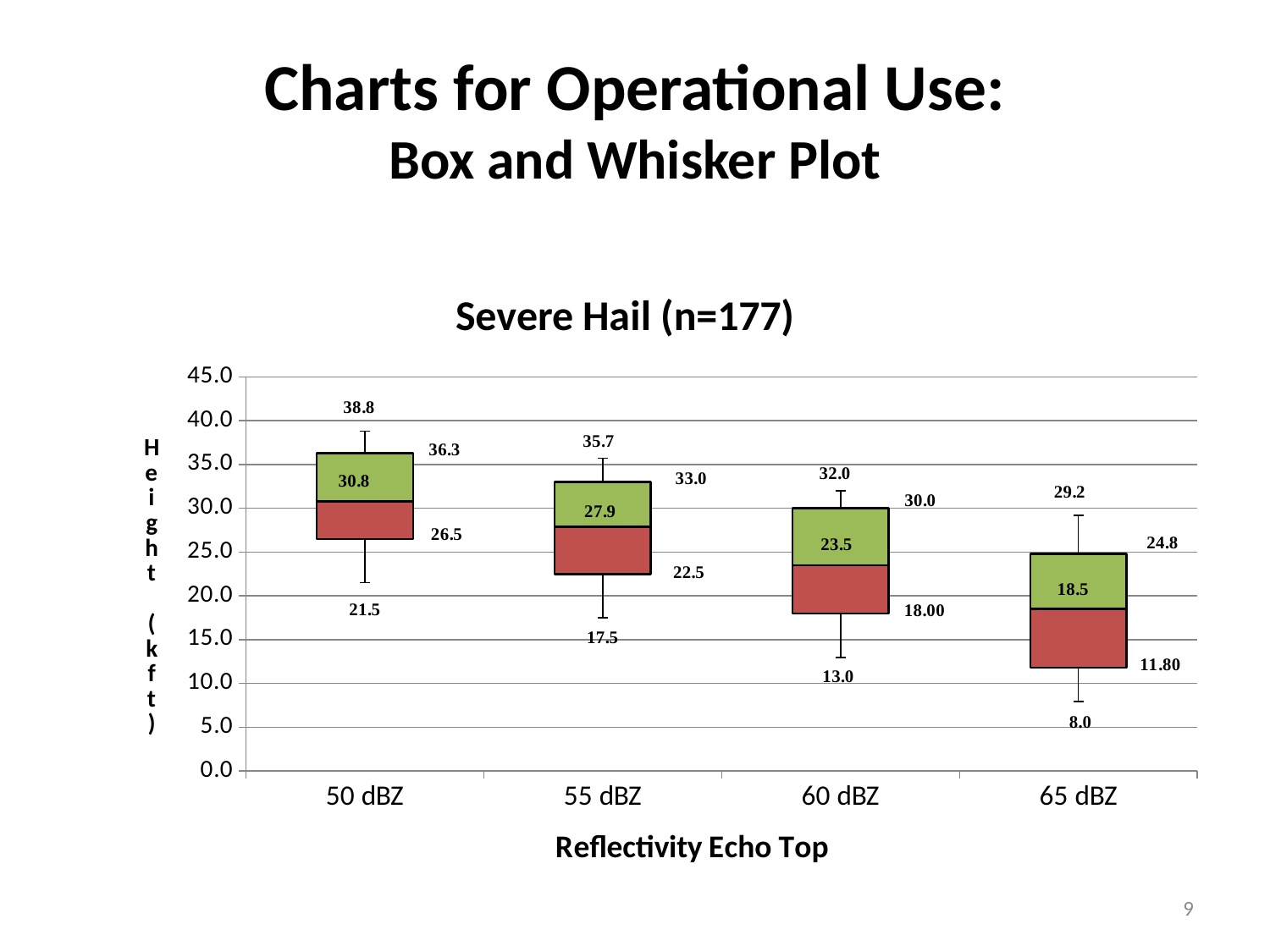
What is the top whisker value for 55 dBZ? 35.7 Do the median heights rise or fall as reflectivity echo top increases from 50 dBZ to 65 dBZ? Fall What kind of chart is shown on the slide? Box and whisker plot Which category has the highest top whisker value? 50 dBZ What is the bottom whisker value for 65 dBZ? 8.0 What is the lower box edge value for 60 dBZ? 18.00 Which has a larger median value, 55 dBZ or 60 dBZ? 55 dBZ What is the difference between the top whisker values for 50 dBZ and 65 dBZ? 9.6 How many reflectivity echo top categories are shown on the x axis? 4 What is the median height (the value printed inside the box) for 50 dBZ? 30.8 What is the title of the chart? Severe Hail (n=177) Which category has the lowest median value? 65 dBZ